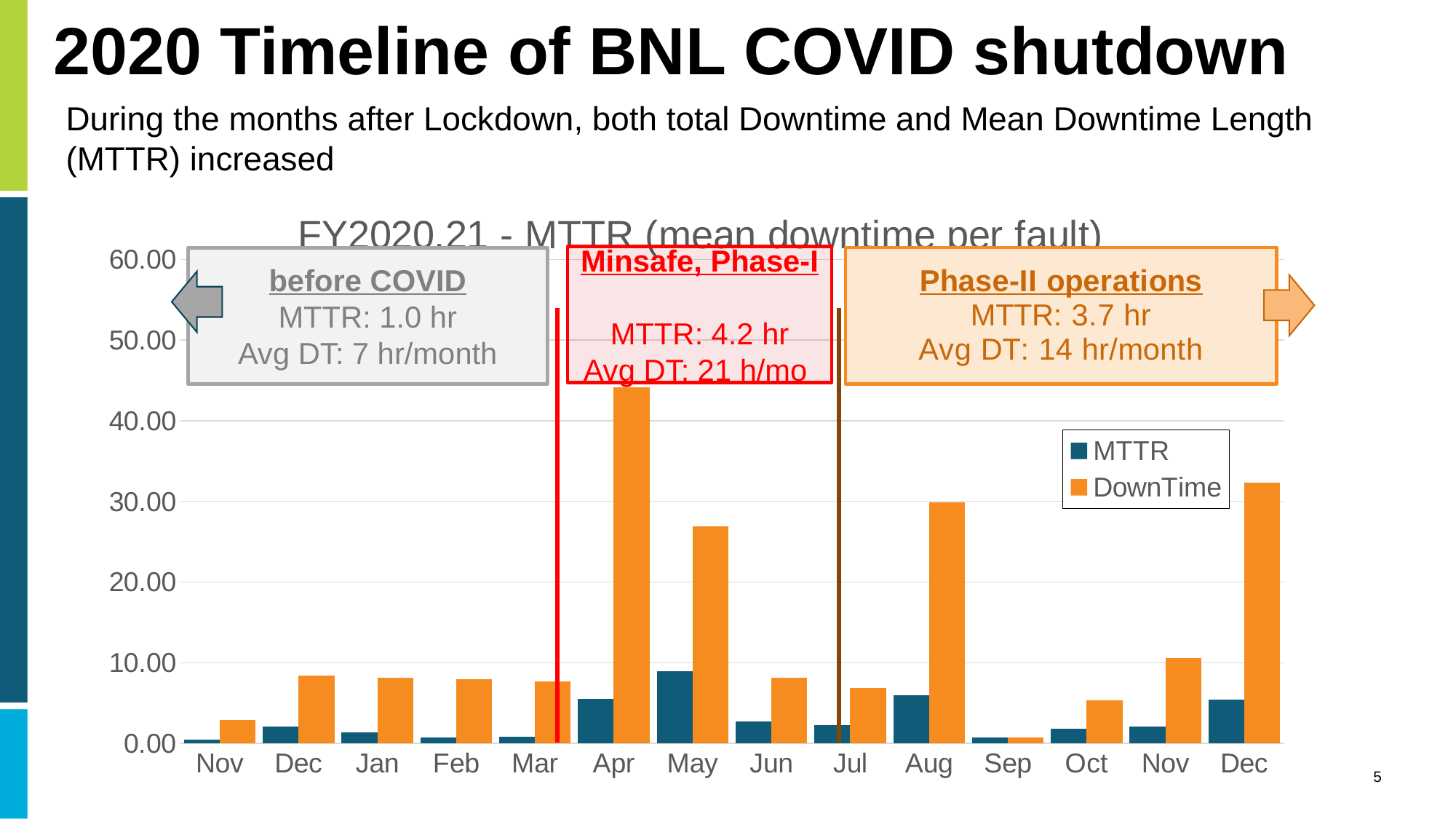
Which month has the lowest DownTime value? Sep Which month has the highest MTTR value? May Is the MTTR value for May greater or less than 10.00? less What is the title of the chart? FY2020,21 - MTTR (mean downtime per fault) Is the DownTime value for Apr greater or less than 40.00? greater How many months are shown along the x axis of the chart? 14 Is the DownTime value for Aug greater or less than 20.00? greater How many series does the chart legend list? 2 Which month has the highest DownTime value? Apr Which has the larger DownTime value, Apr or May? Apr What kind of chart is shown on the slide? bar chart